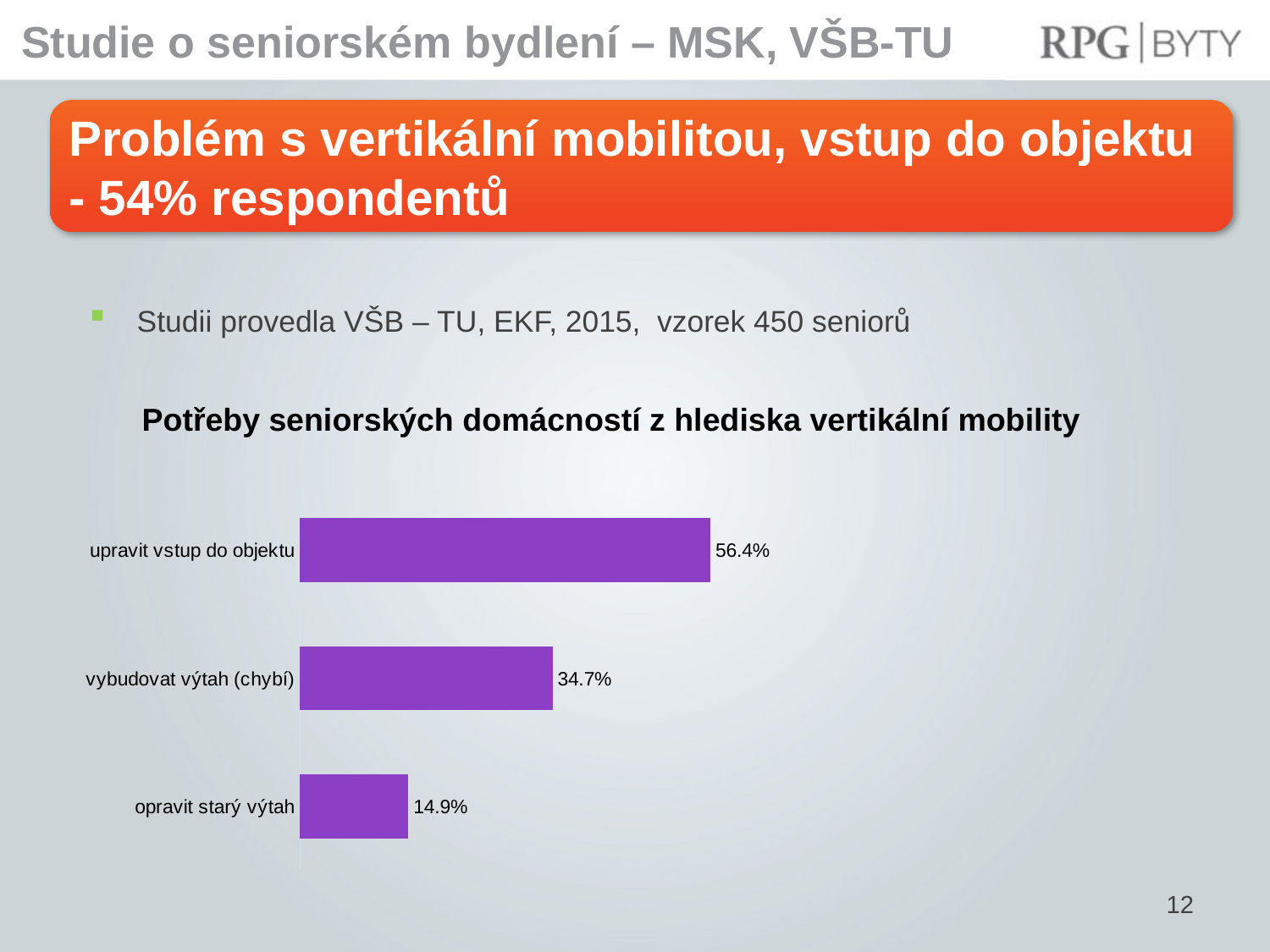
What kind of chart is shown on the slide? bar chart What is the difference between the values for "vybudovat výtah (chybí)" and "opravit starý výtah"? 19.8% Which category has the highest value? upravit vstup do objektu Which category has the lowest value? opravit starý výtah What is the value for "opravit starý výtah"? 14.9% Which is larger, the value for "vybudovat výtah (chybí)" or for "opravit starý výtah"? vybudovat výtah (chybí) What colour are the bars in the chart? purple What is the title of the chart? Potřeby seniorských domácností z hlediska vertikální mobility What is the value for "vybudovat výtah (chybí)"? 34.7% How many categories does the chart show? 3 What is the difference between the values for "upravit vstup do objektu" and "vybudovat výtah (chybí)"? 21.7% What is the value for "upravit vstup do objektu"? 56.4%